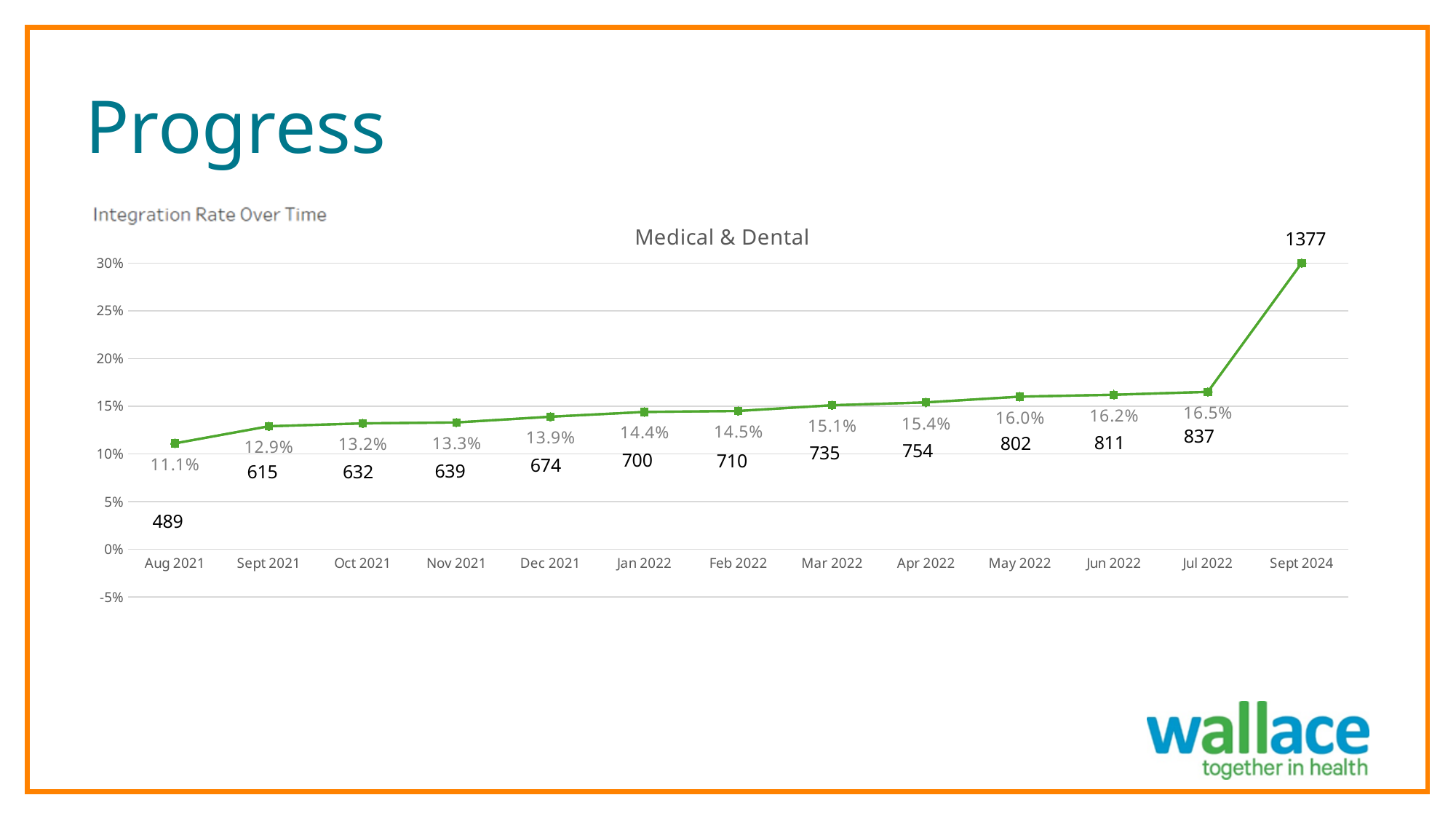
What is the difference between the integration rate in Jul 2022 and Aug 2021? 5.4% What type of chart is shown on the slide? Line chart What is the integration rate for Mar 2022? 15.1% Is the integration rate for Sept 2024 greater or less than 25%? greater Does the integration rate rise or fall from Aug 2021 to Sept 2024? Rise What is the integration rate for Jul 2022? 16.5% Which month has the lowest integration rate? Aug 2021 How many data points are plotted on the line? 13 Which month has the highest integration rate? Sept 2024 What is the integration rate for Aug 2021? 11.1% Which is larger, the integration rate for Dec 2021 or for Feb 2022? Feb 2022